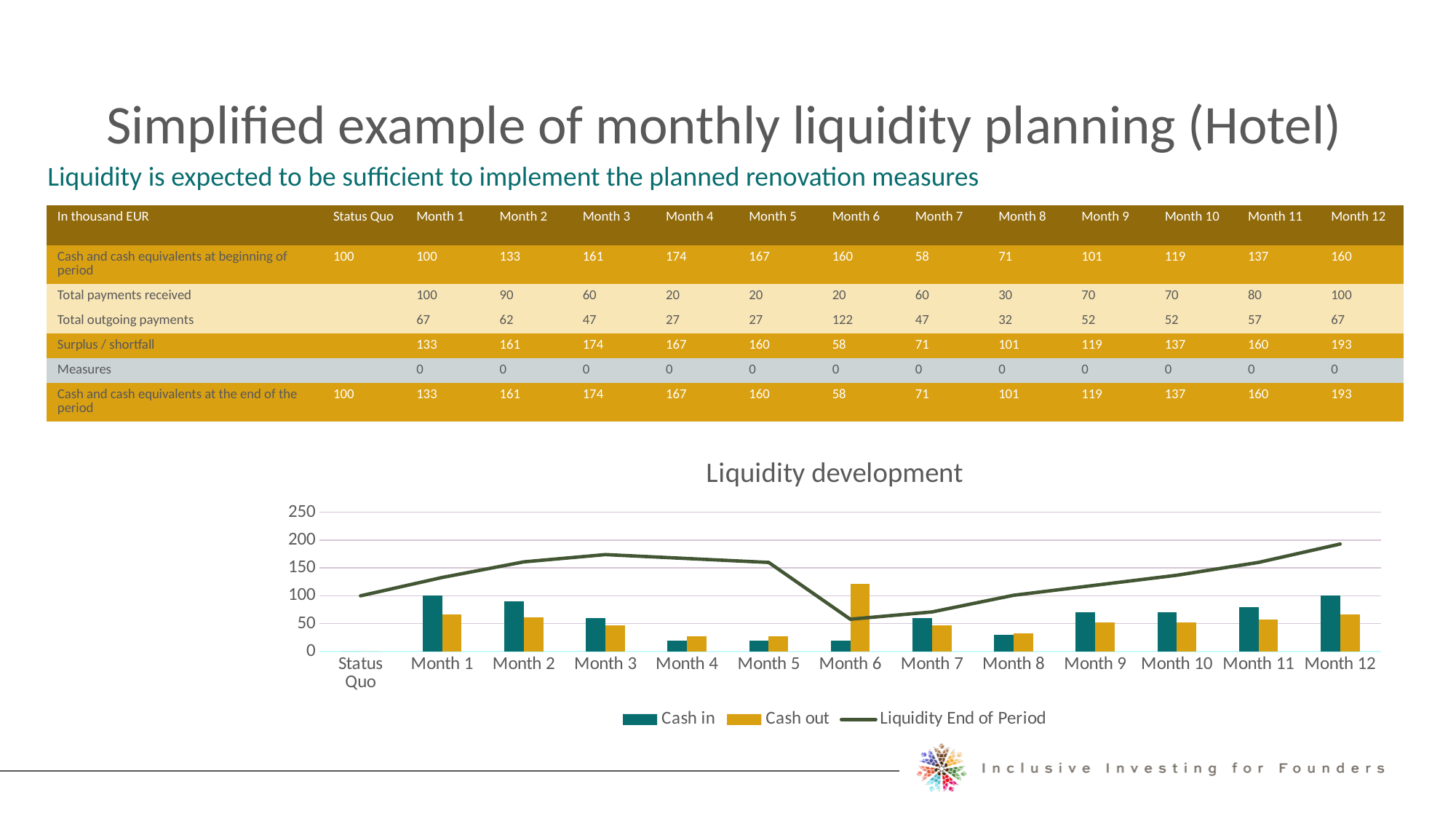
How many categories are shown on the x axis of the "Liquidity development" chart? 13 How many series does the legend of the "Liquidity development" chart list? 3 In the "Liquidity development" chart, which is larger for Month 6: Cash in or Cash out? Cash out In the "Liquidity development" chart, what is the Cash in value for Month 1? 100 In the "Liquidity development" chart, is the Cash out value for Month 6 greater or less than 100? greater In the "Liquidity development" chart, at which month does the Liquidity End of Period line reach its lowest point? Month 6 In the "Liquidity development" chart, does the Liquidity End of Period line rise or fall from Month 6 to Month 12? rise In the "Liquidity development" chart, is the Liquidity End of Period value for Month 3 greater or less than 150? greater In the "Liquidity development" chart, at which month does the Liquidity End of Period line reach its highest point? Month 12 What kind of chart is the "Liquidity development" chart? A bar chart combined with a line In the "Liquidity development" chart, which month has the highest Cash out bar? Month 6 What is the title of the chart on the slide? Liquidity development